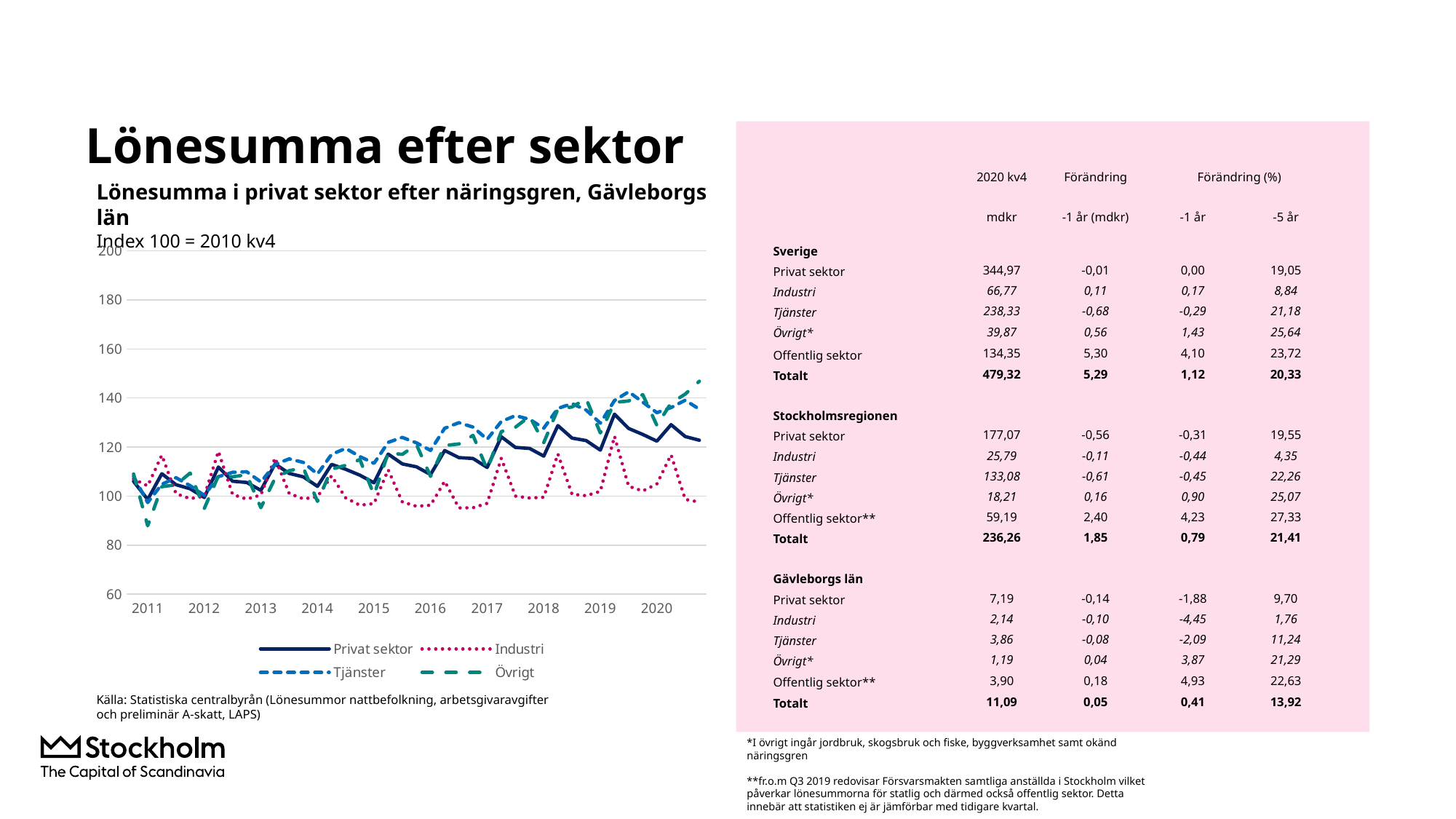
At the end of the chart, which series is higher, Övrigt or Industri? Övrigt Is the value for Övrigt at the end of the chart greater or less than 140? greater Is the value for Industri at the end of the chart greater or less than 120? less Which series has the highest value at the end of the chart (late 2020)? Övrigt What is the title of the chart? Lönesumma i privat sektor efter näringsgren, Gävleborgs län Which series are listed in the chart's legend? Privat sektor, Industri, Tjänster, Övrigt What kind of chart is shown on the slide? Line chart Is the value for Privat sektor at the end of the chart greater or less than 140? less Which series has the lowest value at the end of the chart (late 2020)? Industri How many series does the chart's legend list? 4 Does the Privat sektor line generally rise or fall from 2011 to 2020? Rise How many year labels are shown on the chart's x axis? 10